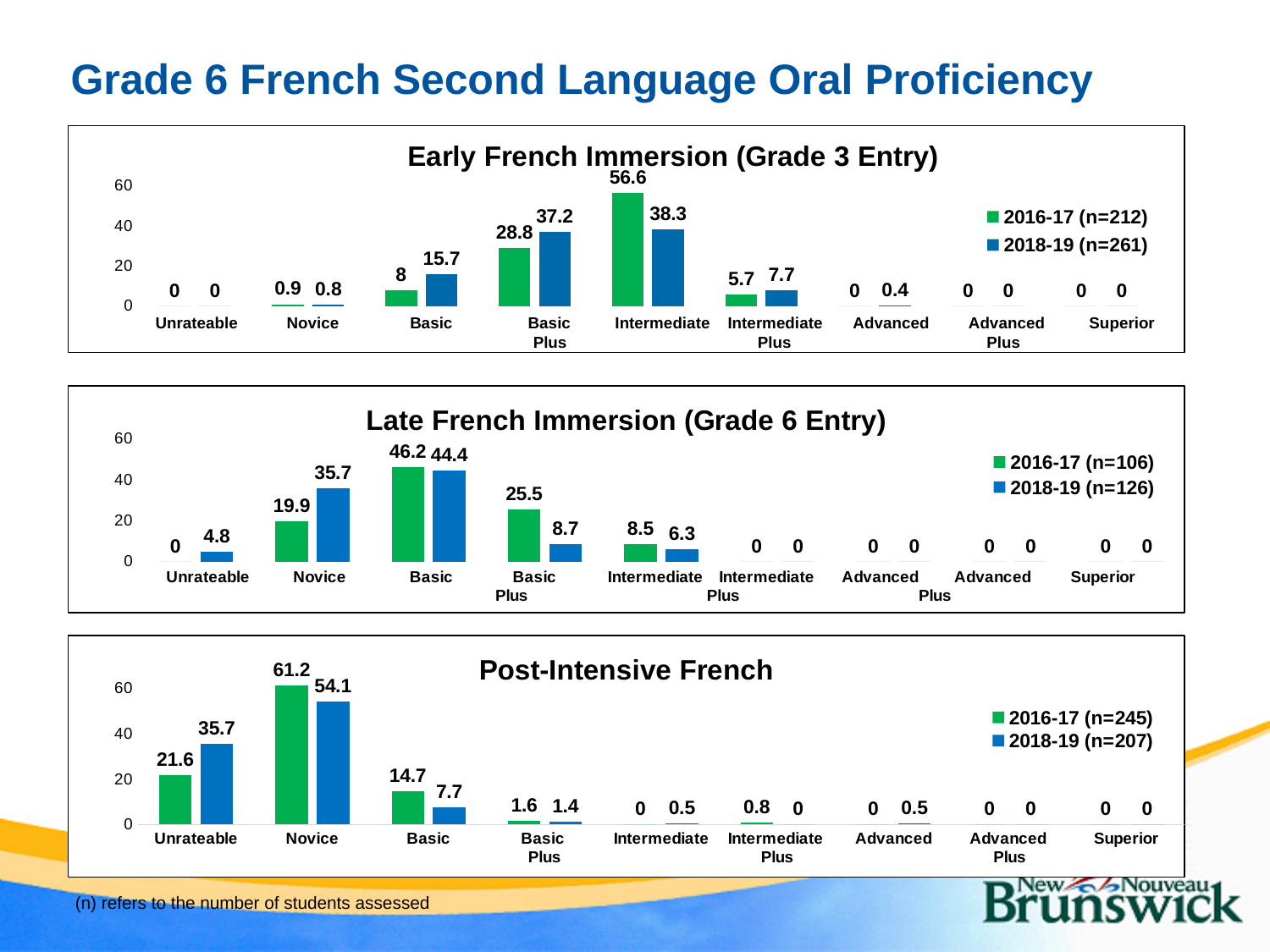
In the Post-Intensive French chart, what is the difference between the 2018-19 and 2016-17 values for Unrateable? 14.1 How many categories are shown on the x axis of the Post-Intensive French chart? 9 In the Early French Immersion (Grade 3 Entry) chart, what is the difference between the 2016-17 and 2018-19 values for Intermediate? 18.3 In the Early French Immersion (Grade 3 Entry) chart, what is the value for Basic Plus in 2018-19 (n=261)? 37.2 In the Early French Immersion (Grade 3 Entry) chart, which category has the highest value for 2018-19 (n=261)? Intermediate In the Post-Intensive French chart, what is the value for Novice in 2016-17 (n=245)? 61.2 In the Late French Immersion (Grade 6 Entry) chart, what is the value for Novice in 2018-19 (n=126)? 35.7 In the Late French Immersion (Grade 6 Entry) chart, which is larger for Basic Plus: the 2016-17 value or the 2018-19 value? 2016-17 In the Early French Immersion (Grade 3 Entry) chart, what is the value for Intermediate in 2016-17 (n=212)? 56.6 In the Late French Immersion (Grade 6 Entry) chart, which category has the highest value for 2016-17 (n=106)? Basic In the Post-Intensive French chart, is the value for Novice in 2018-19 greater or less than 40? greater What type of chart is the Late French Immersion (Grade 6 Entry) chart? Bar chart